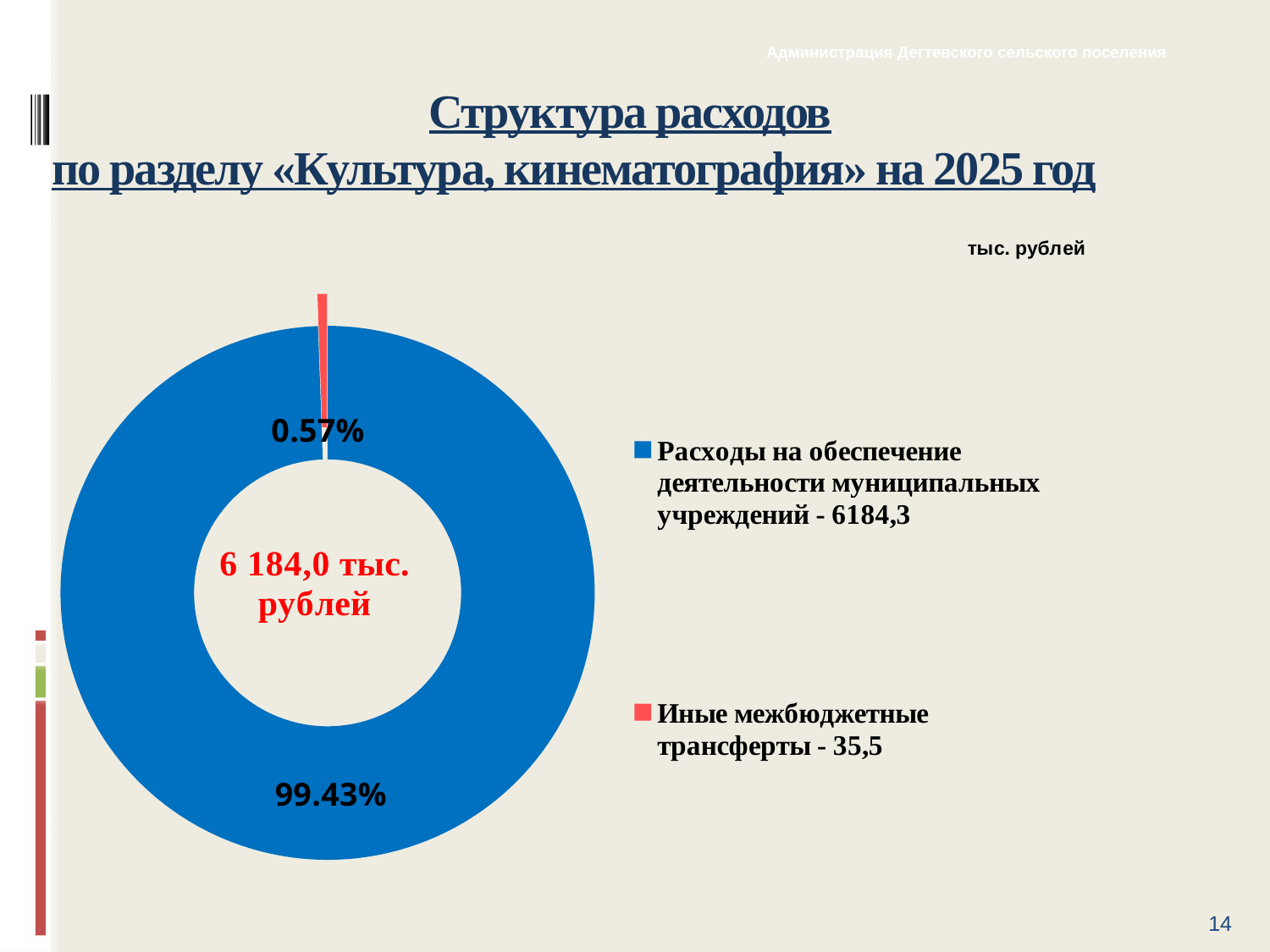
What kind of chart is shown on the slide? Doughnut (pie) chart What amount is printed in the centre of the doughnut chart? 6 184,0 тыс. рублей Which category has the smallest share of the chart? Иные межбюджетные трансферты What value is given in the legend for «Иные межбюджетные трансферты»? 35,5 What percentage share does the slice for «Расходы на обеспечение деятельности муниципальных учреждений» have? 99.43% What colour is the slice for «Иные межбюджетные трансферты»? Red What value is given in the legend for «Расходы на обеспечение деятельности муниципальных учреждений»? 6184,3 What is the difference in percentage points between the two slices of the chart? 98.86 Which category has the largest share of the chart? Расходы на обеспечение деятельности муниципальных учреждений How many categories does the legend of the chart list? 2 What percentage share does the slice for «Иные межбюджетные трансферты» have? 0.57% Which is larger: the share for «Расходы на обеспечение деятельности муниципальных учреждений» or the share for «Иные межбюджетные трансферты»? Расходы на обеспечение деятельности муниципальных учреждений